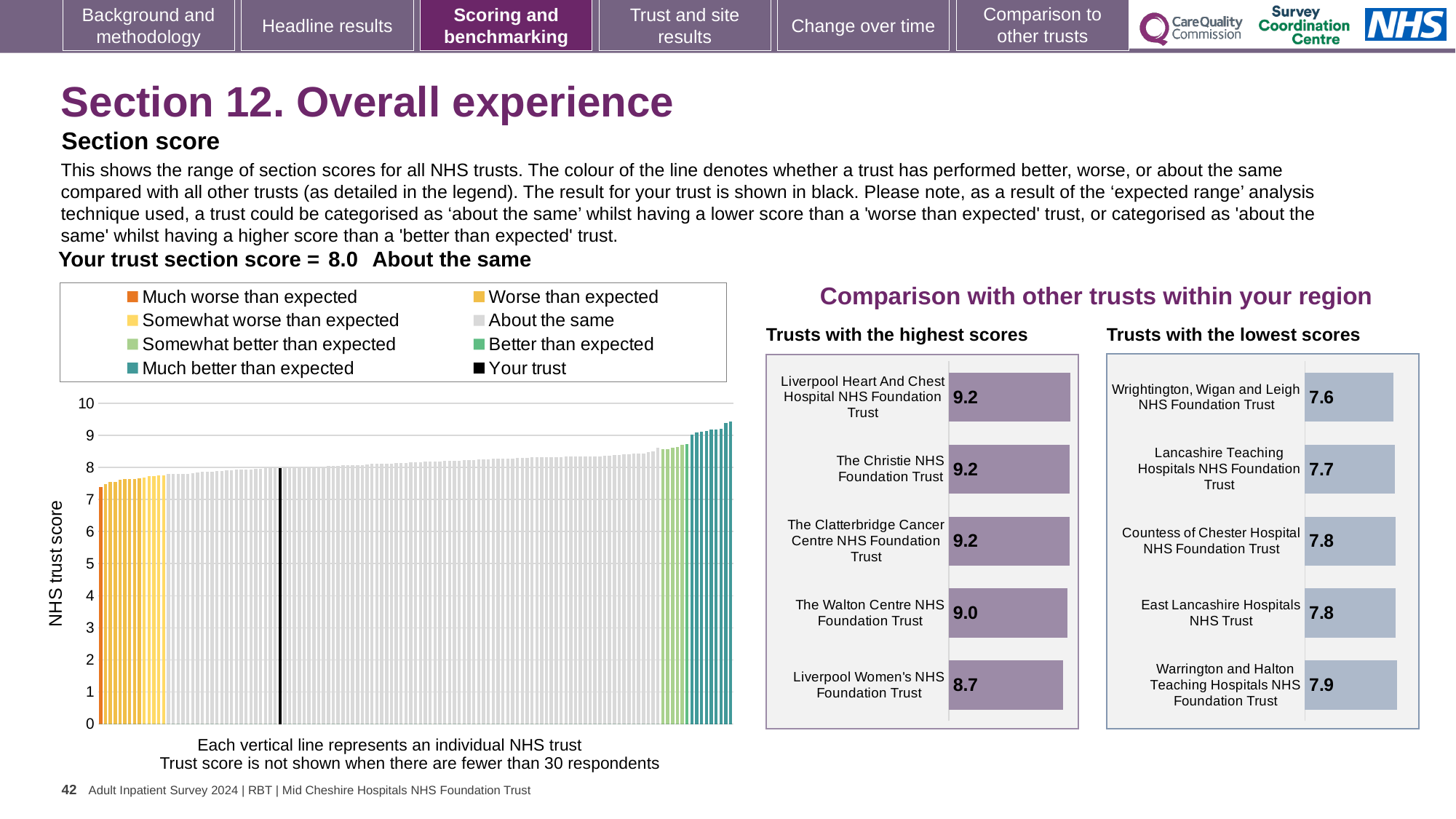
In the 'Trusts with the highest scores' chart, what is the difference between the scores of Liverpool Heart And Chest Hospital NHS Foundation Trust and Liverpool Women's NHS Foundation Trust? 0.5 In the main NHS trust score chart, do the values rise or fall from left to right? Rise How many entries does the legend of the main NHS trust score chart list? 8 What kind of chart is the main chart showing the NHS trust scores for all trusts? Bar chart In the 'Trusts with the lowest scores' chart, which has the higher score: Countess of Chester Hospital NHS Foundation Trust or Lancashire Teaching Hospitals NHS Foundation Trust? Countess of Chester Hospital NHS Foundation Trust In the 'Trusts with the lowest scores' chart, what is the difference between the scores of Warrington and Halton Teaching Hospitals NHS Foundation Trust and Wrightington, Wigan and Leigh NHS Foundation Trust? 0.3 In the 'Trusts with the lowest scores' chart, what is the score for Wrightington, Wigan and Leigh NHS Foundation Trust? 7.6 In the 'Trusts with the lowest scores' chart, which trust has the highest score? Warrington and Halton Teaching Hospitals NHS Foundation Trust How many trusts are shown in the 'Trusts with the highest scores' chart? 5 In the 'Trusts with the highest scores' chart, which trust has the lowest score? Liverpool Women's NHS Foundation Trust According to the slide, what is your trust's section score for Overall experience? 8.0 In the 'Trusts with the highest scores' chart, what is the score for The Walton Centre NHS Foundation Trust? 9.0